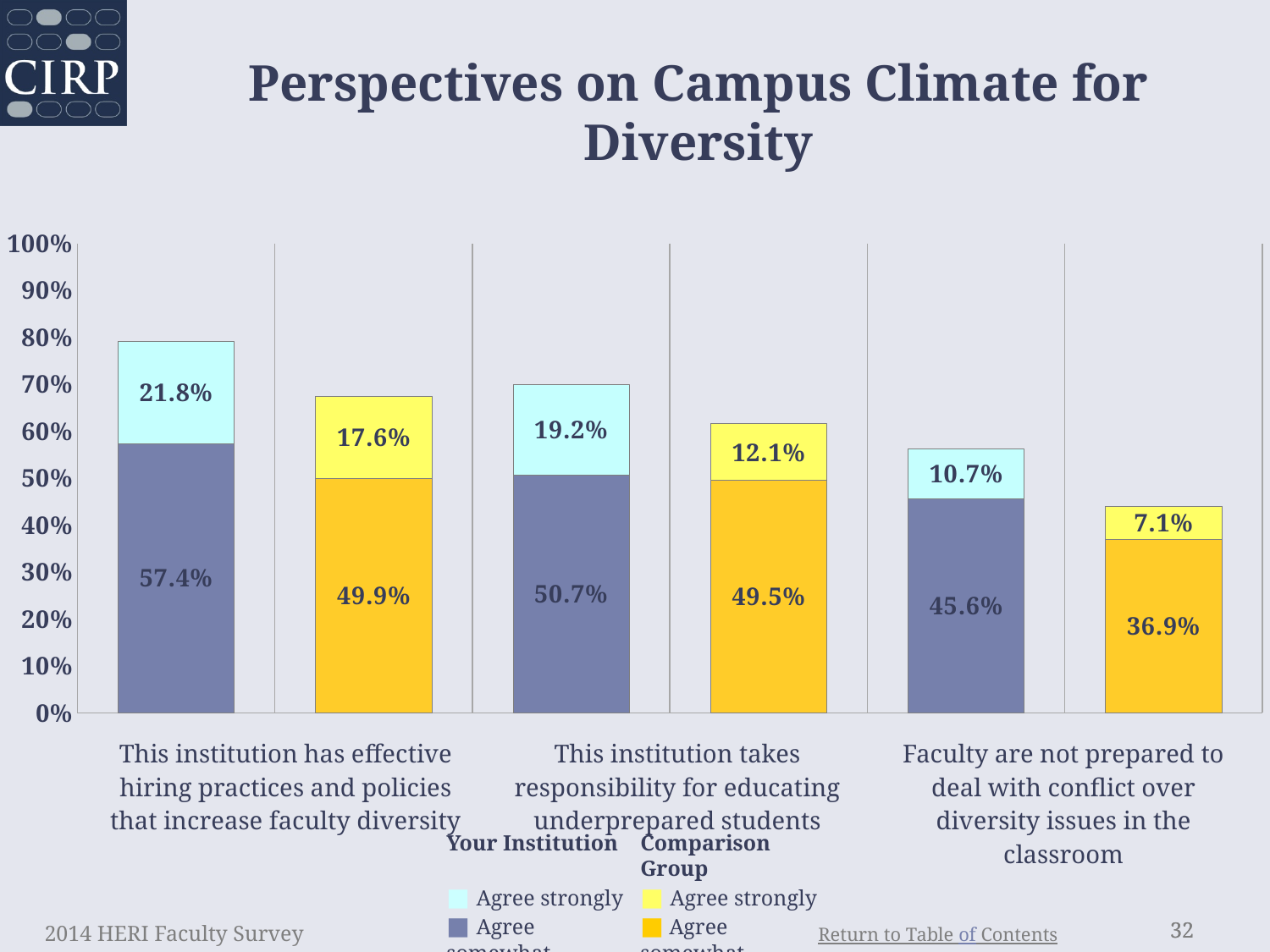
Which statement has the lowest 'Agree strongly' value for the Comparison Group? Faculty are not prepared to deal with conflict over diversity issues in the classroom What percentage of faculty at Your Institution agree strongly that this institution has effective hiring practices and policies that increase faculty diversity? 21.8% Which has the larger 'Agree somewhat' value for the statement that faculty are not prepared to deal with conflict over diversity issues in the classroom: Your Institution or the Comparison Group? Your Institution What is the total percentage (agree strongly plus agree somewhat) for the Comparison Group on the statement that faculty are not prepared to deal with conflict over diversity issues in the classroom? 44.0% Which statement has the highest 'Agree somewhat' value for Your Institution? This institution has effective hiring practices and policies that increase faculty diversity What percentage of the Comparison Group agree somewhat that faculty are not prepared to deal with conflict over diversity issues in the classroom? 36.9% What type of chart is shown on the slide? Stacked bar chart Is the total height of the Your Institution bar for the statement that faculty are not prepared to deal with conflict over diversity issues in the classroom greater or less than 50%? greater What is the difference between the Your Institution and Comparison Group 'Agree strongly' values for the statement that this institution takes responsibility for educating underprepared students? 7.1% What percentage of the Comparison Group agree strongly that this institution takes responsibility for educating underprepared students? 12.1% What is the total percentage (agree strongly plus agree somewhat) for Your Institution on the statement that this institution has effective hiring practices and policies that increase faculty diversity? 79.2% How many statements (categories) are shown on the x axis of the chart? 3